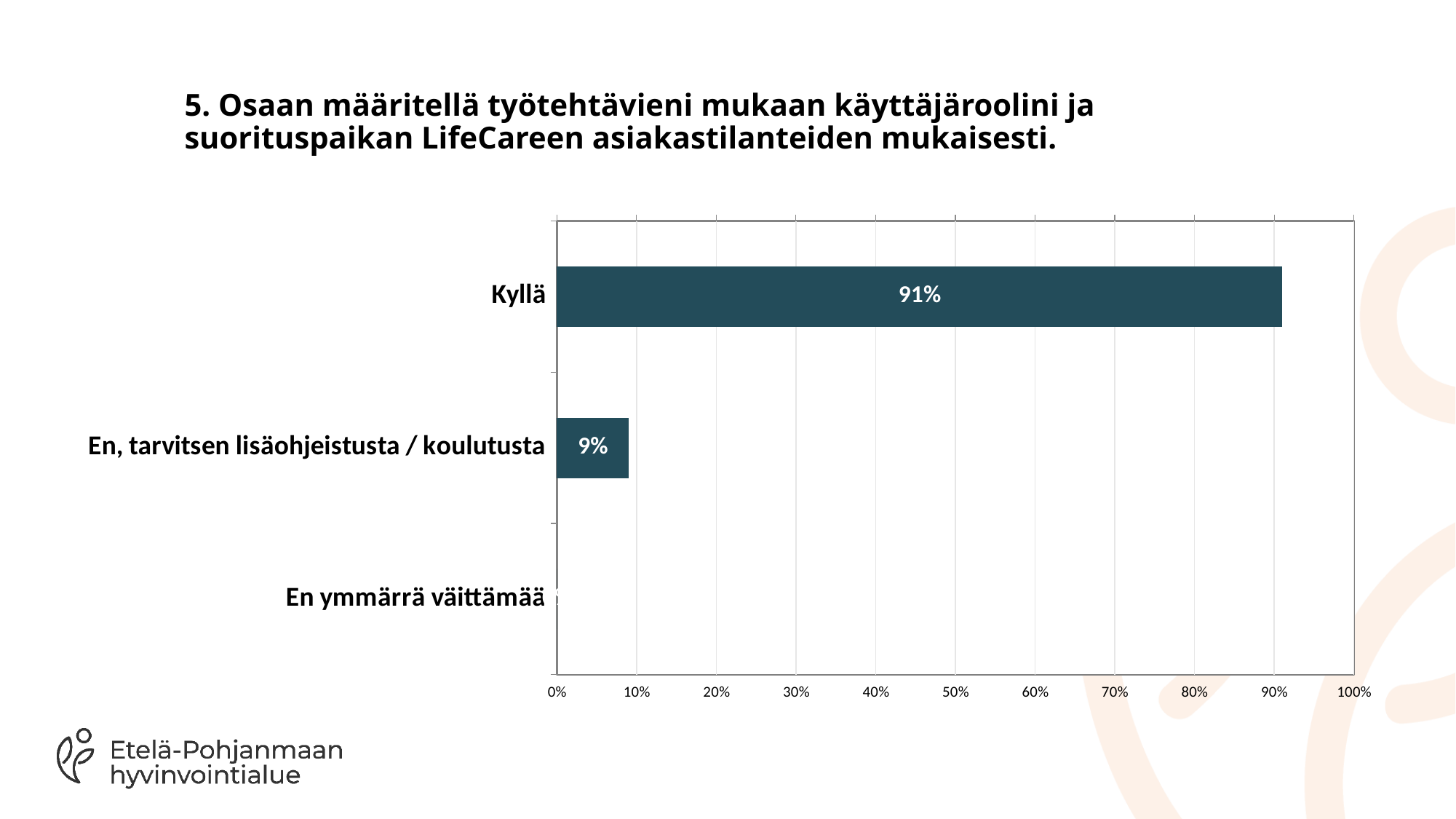
Which category has the highest value? Kyllä What is the difference between the values for Kyllä and "En, tarvitsen lisäohjeistusta / koulutusta"? 82% What is the maximum value shown on the horizontal axis? 100% What kind of chart is shown on the slide? Bar chart Which is larger, the value for Kyllä or the value for "En, tarvitsen lisäohjeistusta / koulutusta"? Kyllä How many categories are shown in the chart? 3 What is the value for Kyllä? 91% What is the value for "En, tarvitsen lisäohjeistusta / koulutusta"? 9% Is the value for "En, tarvitsen lisäohjeistusta / koulutusta" greater or less than 20%? less Which category has the lowest value? En ymmärrä väittämää Is the value for Kyllä greater or less than 50%? greater What is the total of the values for Kyllä and "En, tarvitsen lisäohjeistusta / koulutusta"? 100%